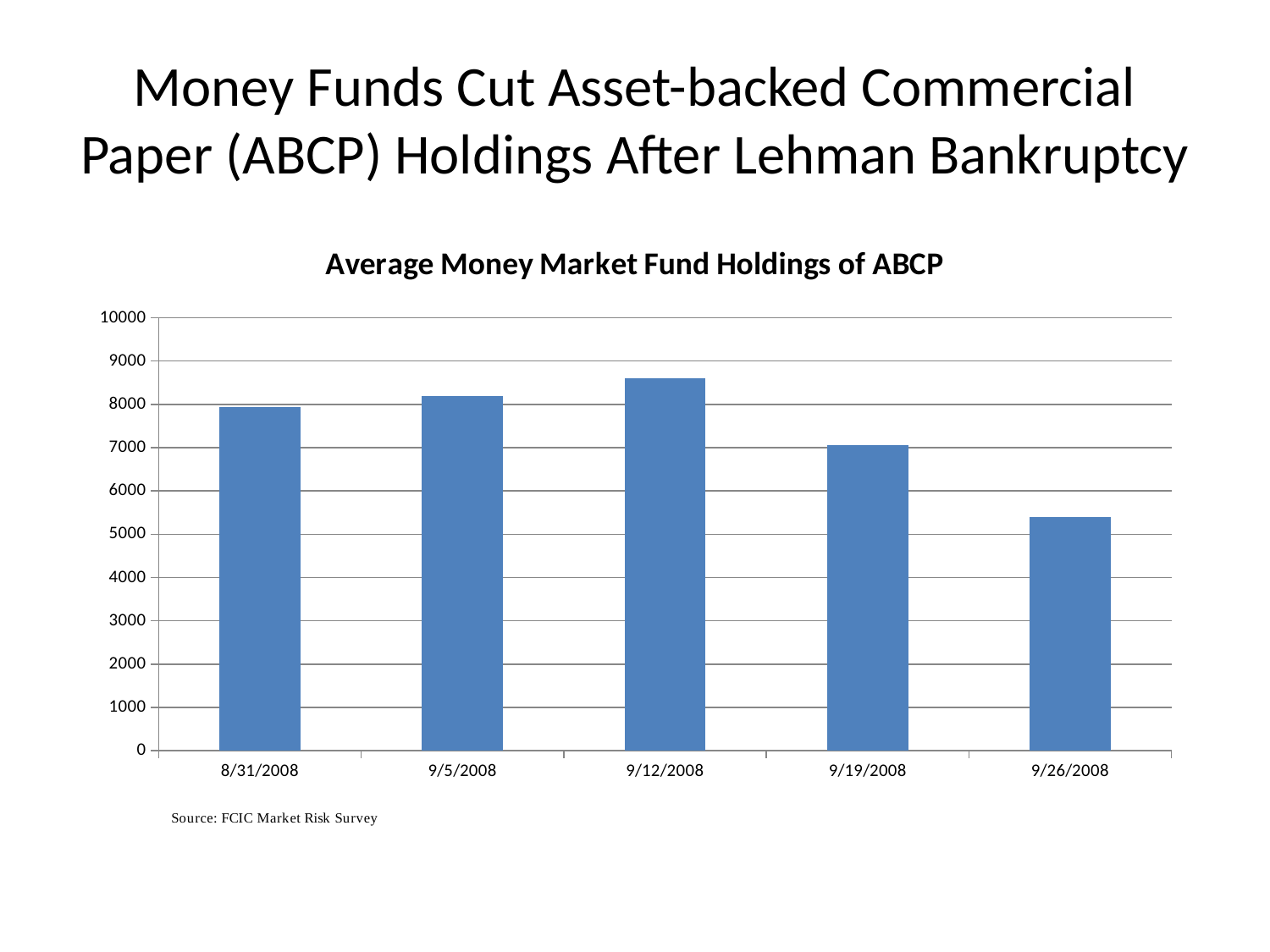
What source is cited below the chart? FCIC Market Risk Survey What kind of chart is shown on the slide? bar chart How many dates are plotted on the x axis of the chart? 5 Which date has the lowest average money market fund holdings of ABCP? 9/26/2008 Is the value for 8/31/2008 greater or less than 7000? greater Which date has the highest average money market fund holdings of ABCP? 9/12/2008 Is the value for 9/12/2008 greater or less than 8000? greater Is the value for 9/26/2008 greater or less than 6000? less What is the title of the chart? Average Money Market Fund Holdings of ABCP Which is larger, the value for 9/12/2008 or the value for 9/19/2008? 9/12/2008 Do the values rise or fall from 9/12/2008 to 9/26/2008? fall